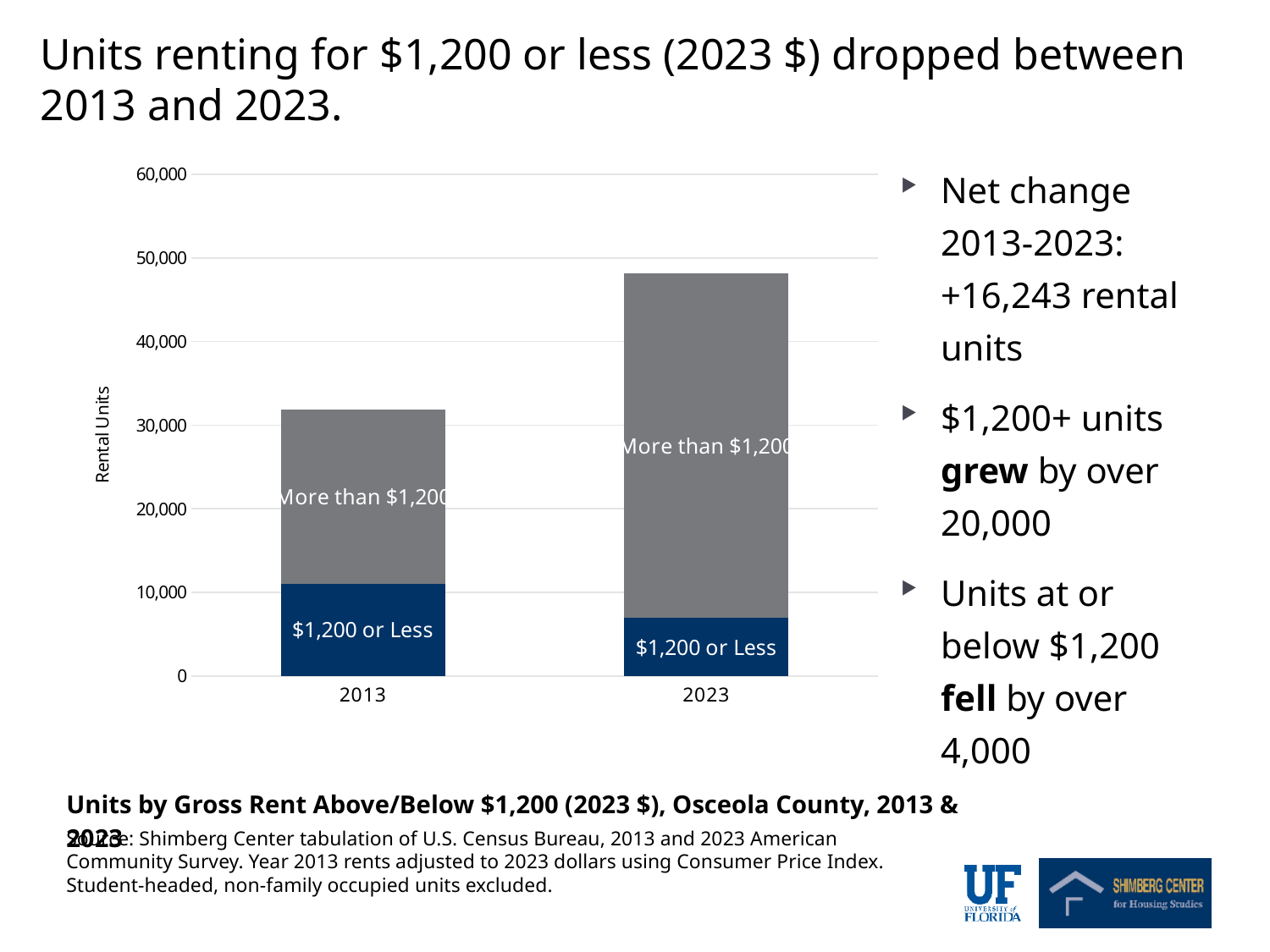
Does the total number of rental units rise or fall from 2013 to 2023? rise Is the total height of the 2023 bar greater or less than 50,000? less Is the total height of the 2013 bar greater or less than 30,000? greater Which year has the larger "More than $1,200" segment, 2013 or 2023? 2023 Which year has the larger "$1,200 or Less" segment, 2013 or 2023? 2013 What is the label on the vertical axis of the chart? Rental Units Does the "$1,200 or Less" segment rise or fall from 2013 to 2023? fall How many years (categories) are shown on the x axis of the chart? 2 How many rent segments make up each stacked bar in the chart? 2 Which year has the taller total bar, 2013 or 2023? 2023 Is the "$1,200 or Less" segment for 2023 greater or less than 10,000? less What kind of chart is shown on the slide? stacked bar chart